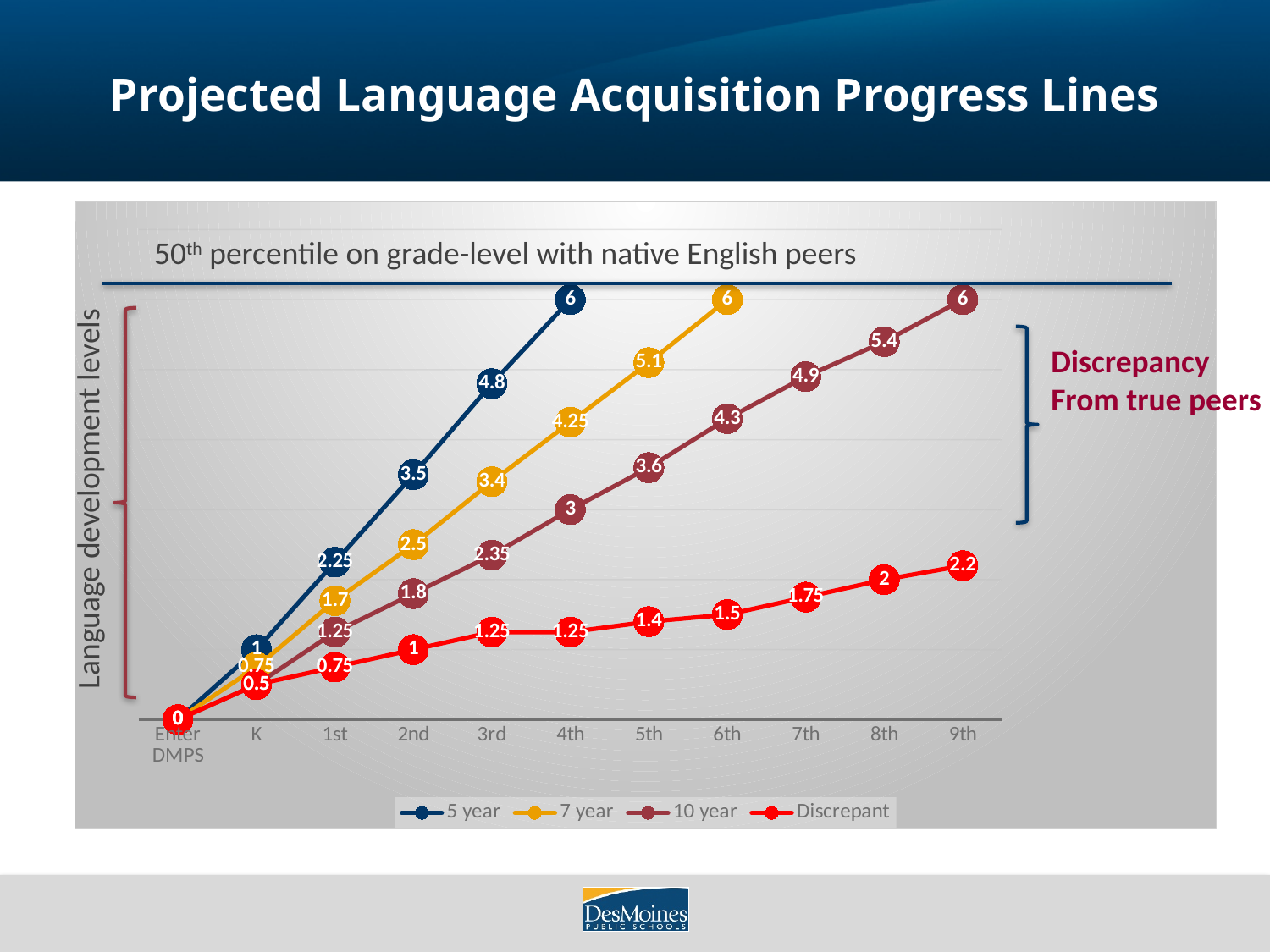
At which grade does the 5 year series reach a value of 6? 4th How many categories are on the x axis? 11 At 2nd grade, which is larger: the 5 year value or the 7 year value? 5 year What is the value of the Discrepant series at 9th grade? 2.2 Which series has the lowest value at 8th grade? Discrepant What is the value of the 10 year series at 6th grade? 4.3 What is the value of the 5 year series at 3rd grade? 4.8 What kind of chart is shown on the slide? line chart At 9th grade, what is the difference between the 10 year value and the Discrepant value? 3.8 How many series does the legend list? 4 What is the value of the 7 year series at 5th grade? 5.1 Do the values of the Discrepant series rise or fall from Enter DMPS to 9th grade? rise